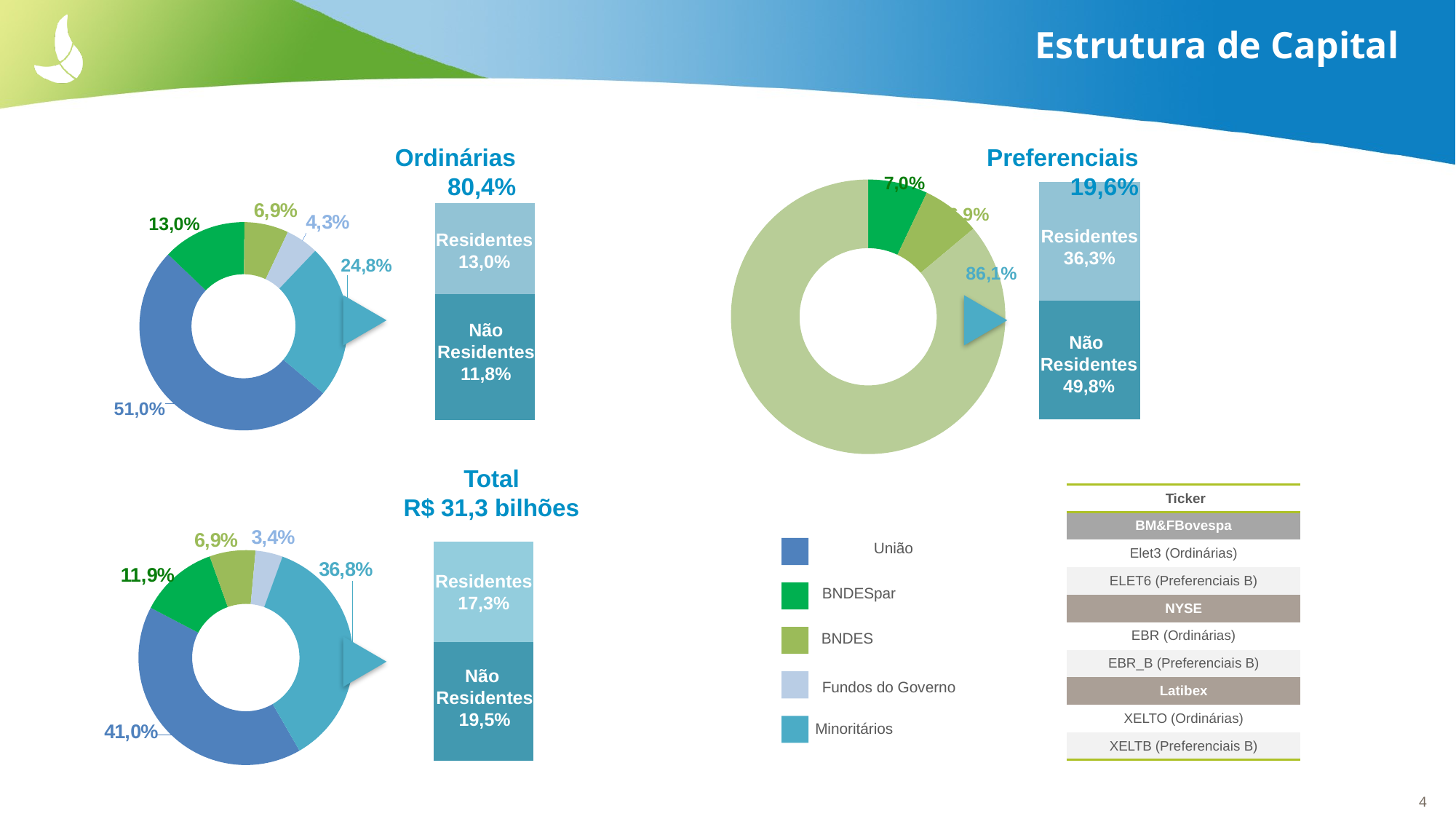
In the Ordinárias stacked bar, what is the value for Não Residentes? 11,8% In the Ordinárias donut chart, which category has the largest share? União In the Ordinárias donut chart, which category has the smallest share? Fundos do Governo In the Preferenciais donut chart, what is the value of the largest slice? 86,1% In the Ordinárias donut chart, what share is labelled for Minoritários? 24,8% In the Preferenciais stacked bar, what is the difference between Não Residentes and Residentes? 13,5% In the Total donut chart, what share is labelled for BNDESpar? 11,9% How many categories does the legend list for the donut charts? 5 In the Total donut chart, which is larger, União or Minoritários? União In the Total stacked bar, what is the difference between Não Residentes and Residentes? 2,2% In the Preferenciais stacked bar, what is the value for Residentes? 36,3% In the Ordinárias donut chart, what share is labelled for União? 51,0%